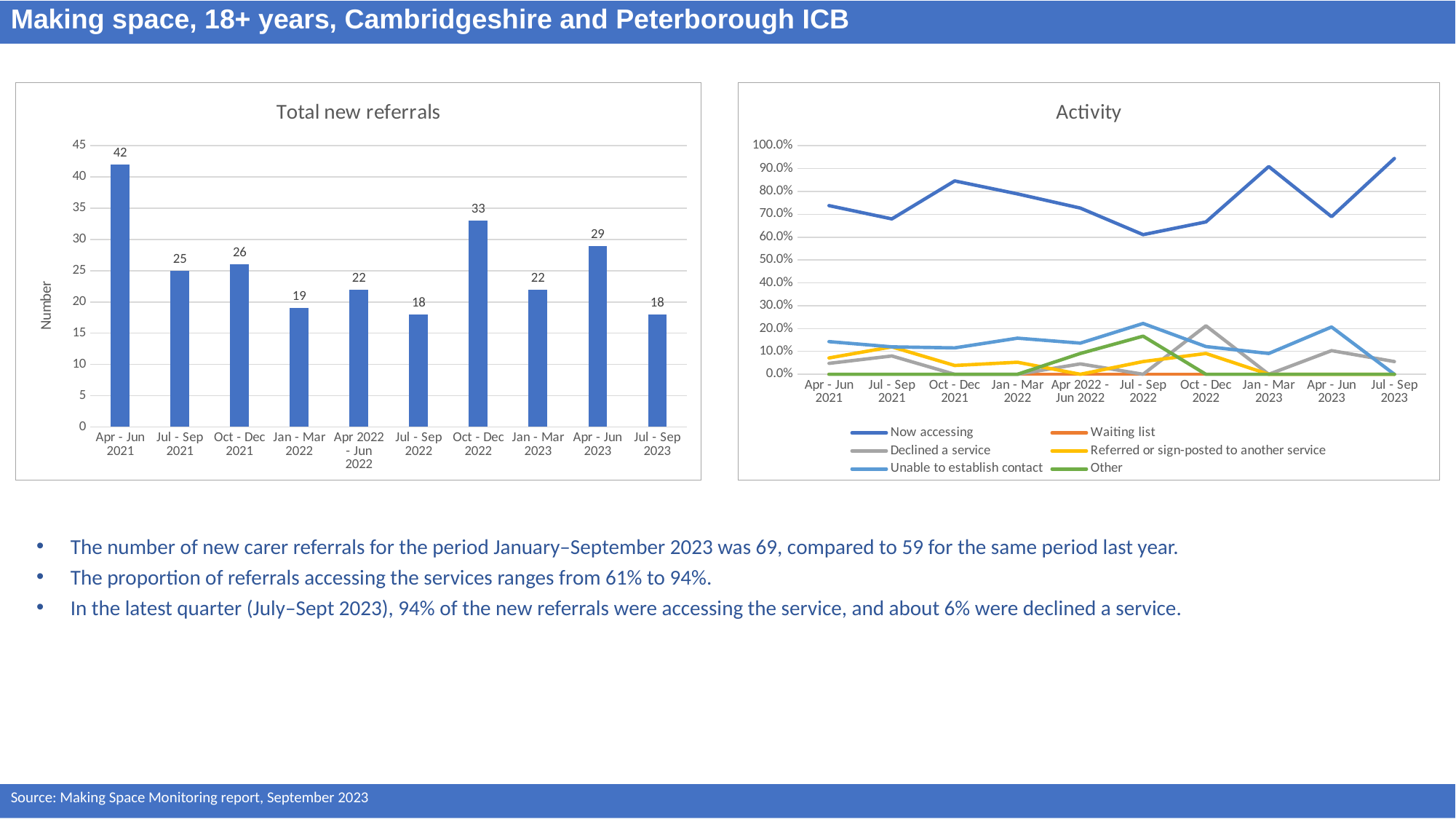
In the 'Total new referrals' chart, what is the value for Oct - Dec 2022? 33 In the 'Activity' chart, is the value for 'Now accessing' in Jul - Sep 2023 greater or less than 90.0%? greater What kind of chart is the 'Activity' chart? Line chart In the 'Total new referrals' chart, which is larger: Apr - Jun 2023 or Jan - Mar 2023? Apr - Jun 2023 In the 'Total new referrals' chart, what is the difference between Apr - Jun 2021 and Jul - Sep 2021? 17 In the 'Total new referrals' chart, what is the value for Apr - Jun 2021? 42 What kind of chart is the 'Total new referrals' chart? Bar chart In the 'Activity' chart, how many series does the legend list? 6 In the 'Activity' chart, is the value for 'Now accessing' in Jul - Sep 2022 greater or less than 70.0%? less In the 'Total new referrals' chart, how many quarters are shown on the x axis? 10 In the 'Activity' chart, which series is shown in green in the legend? Other In the 'Total new referrals' chart, which quarter has the highest number of referrals? Apr - Jun 2021